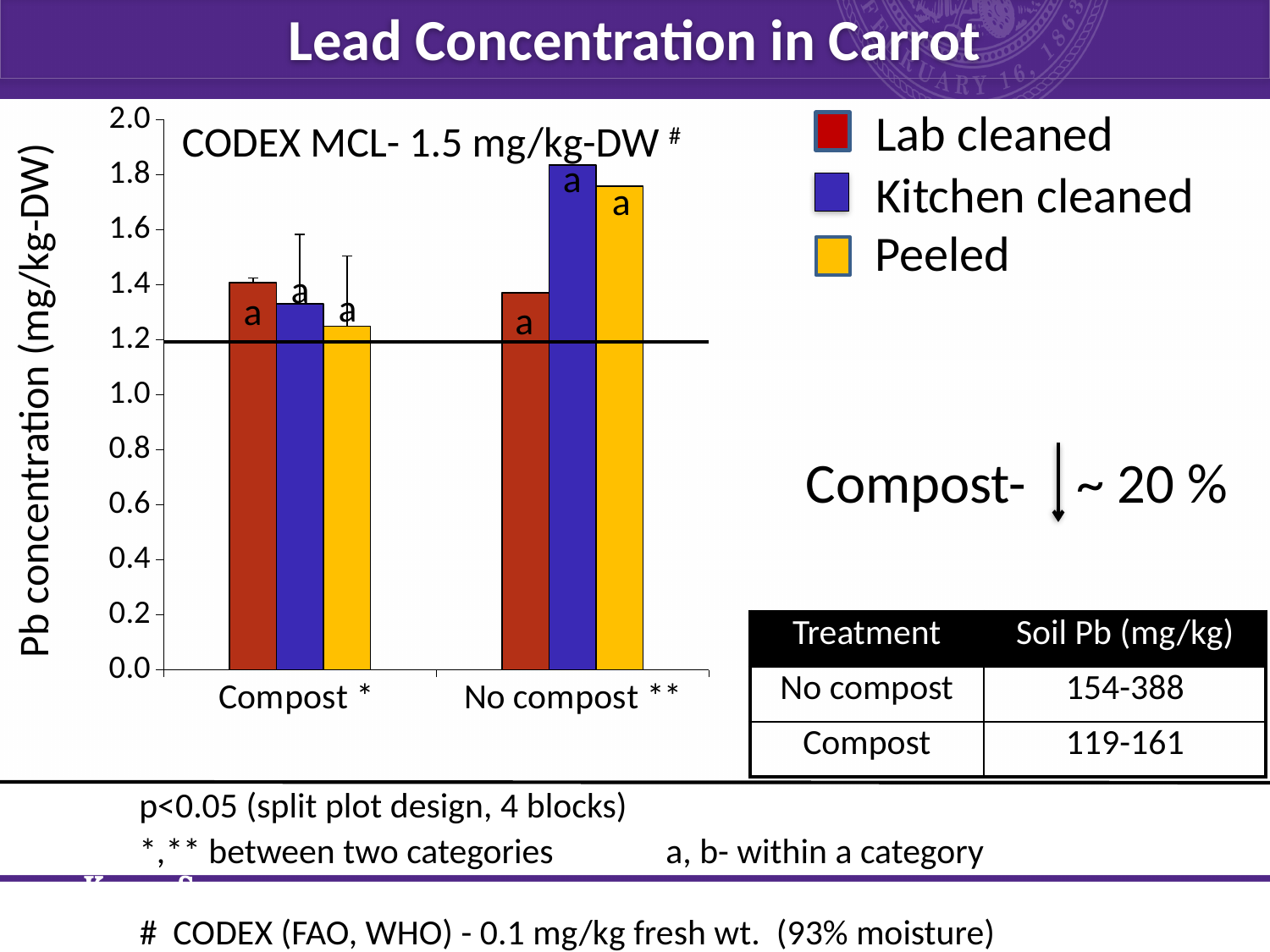
Is the Kitchen cleaned value for No compost greater or less than 1.6? greater Which is larger, the Kitchen cleaned value for Compost or for No compost? No compost What are the three series listed in the chart legend? Lab cleaned, Kitchen cleaned, Peeled How many series does the chart legend list? 3 How many categories are shown on the x axis of the chart? 2 Which is larger, the Lab cleaned value for Compost or the Peeled value for Compost? Lab cleaned Is the Peeled value for Compost greater or less than 1.4? less What kind of chart is shown on the slide? bar chart Which series has the lowest bar in the No compost category? Lab cleaned Which series has the highest bar in the No compost category? Kitchen cleaned Is the Lab cleaned value for Compost greater or less than 1.2? greater What is the label of the y axis of the chart? Pb concentration (mg/kg-DW)